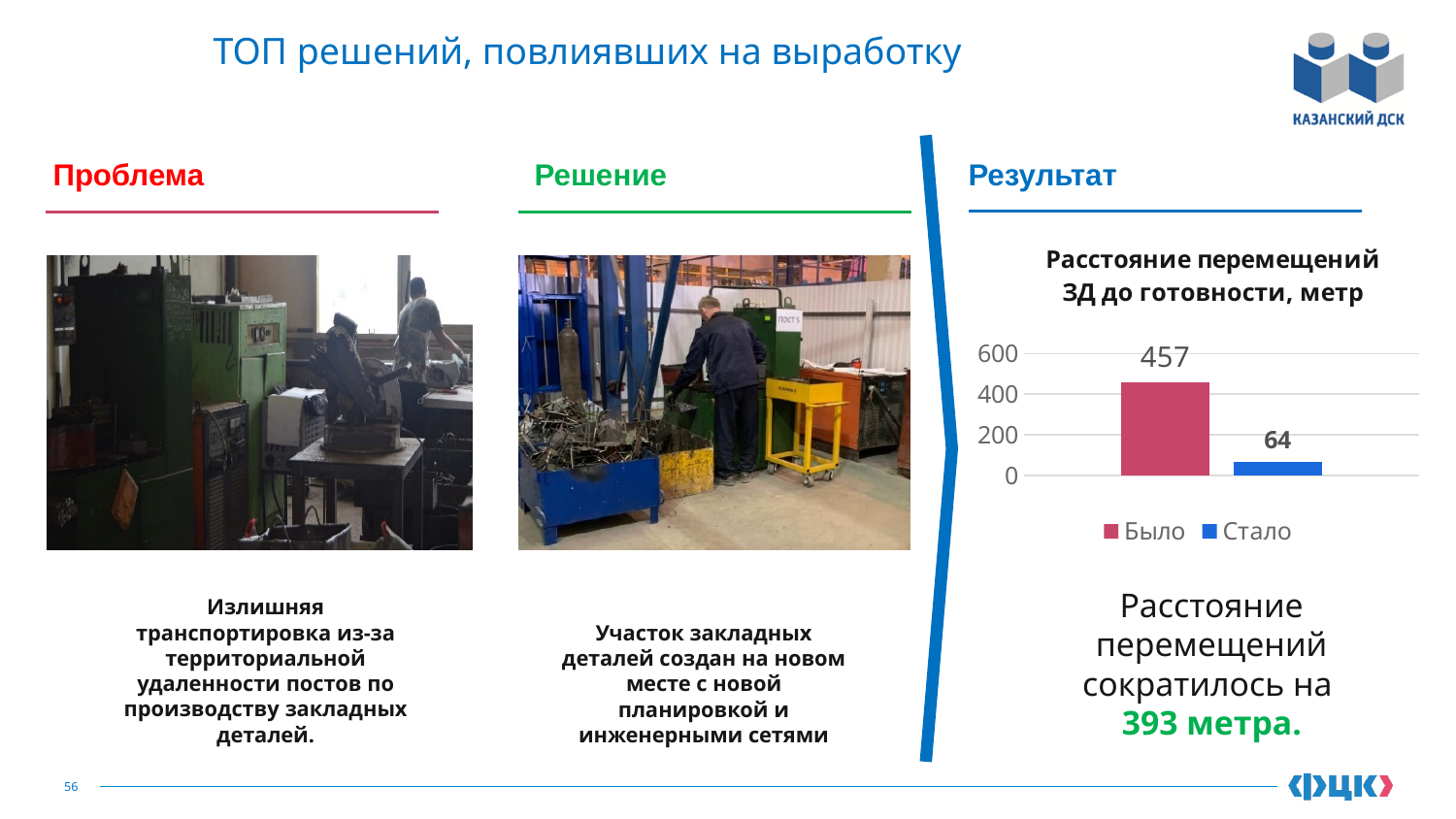
Is the value for "Было" greater or less than 400? greater Which series has the lowest value in the chart? Стало What colour is the "Стало" bar? blue How many series does the legend list? 2 What is the value for "Было" in the chart? 457 What kind of chart is shown on the slide? bar chart Is the value for "Стало" greater or less than 200? less What is the difference between the "Было" and "Стало" values? 393 How many bars are plotted in the chart? 2 Which series has the higher value, "Было" or "Стало"? Было What is the title of the chart? Расстояние перемещений ЗД до готовности, метр What is the value for "Стало" in the chart? 64